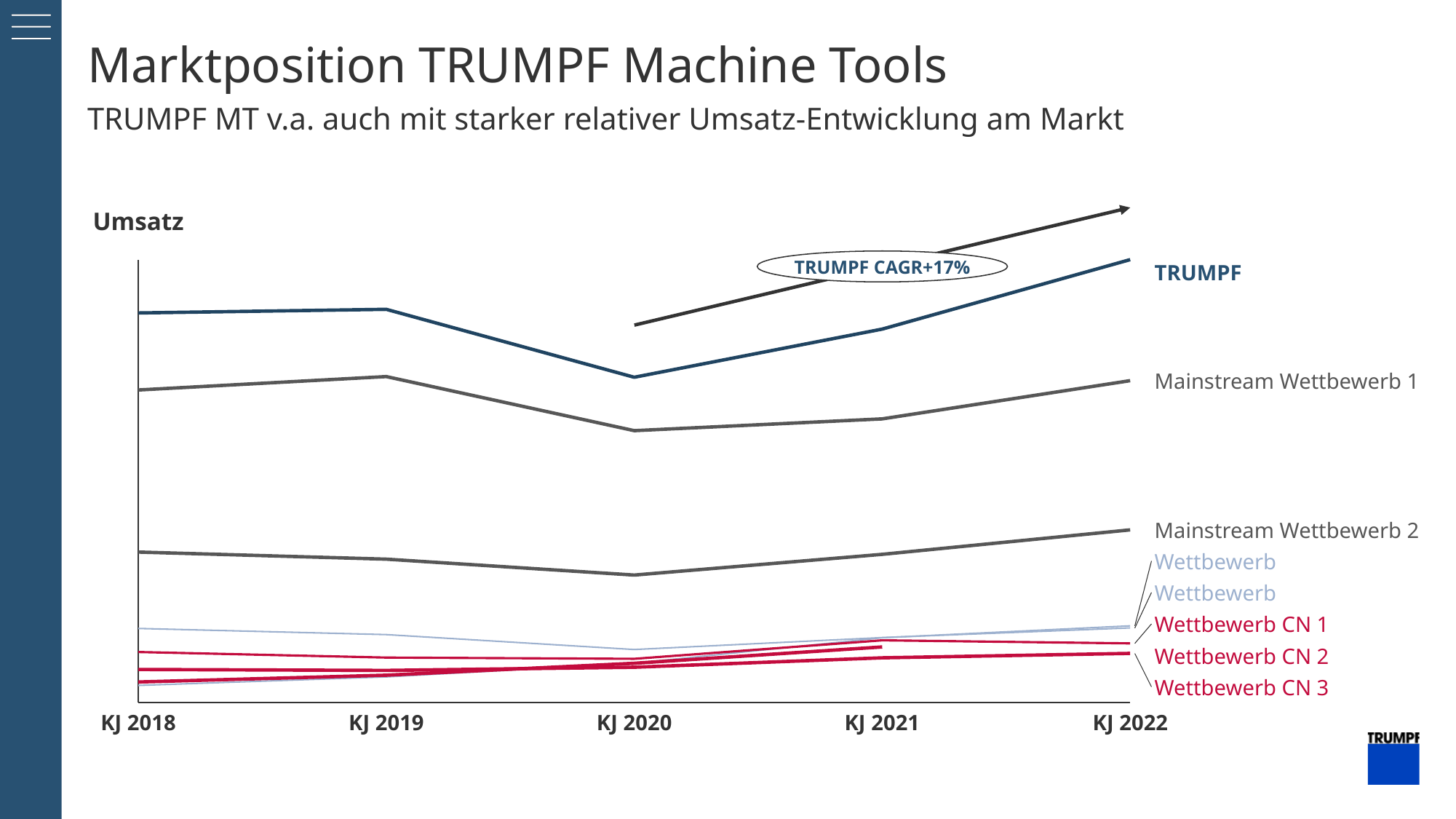
What CAGR is stated for TRUMPF in the annotation on the chart? +17% What is the label of the y axis of the chart? Umsatz Does the TRUMPF line rise or fall from KJ 2019 to KJ 2020? Falls How many years are shown on the x axis of the chart? 5 What kind of chart is shown on the slide? Line chart What is the first year shown on the x axis of the chart? KJ 2018 Which series has the highest Umsatz in KJ 2022? TRUMPF Which series has the highest Umsatz in KJ 2018? TRUMPF In KJ 2020, which is larger: the value for Mainstream Wettbewerb 1 or for Mainstream Wettbewerb 2? Mainstream Wettbewerb 1 Does the TRUMPF line rise or fall from KJ 2020 to KJ 2022? Rises Does the Mainstream Wettbewerb 2 line rise or fall from KJ 2018 to KJ 2020? Falls In KJ 2022, which is larger: the value for TRUMPF or for Mainstream Wettbewerb 1? TRUMPF